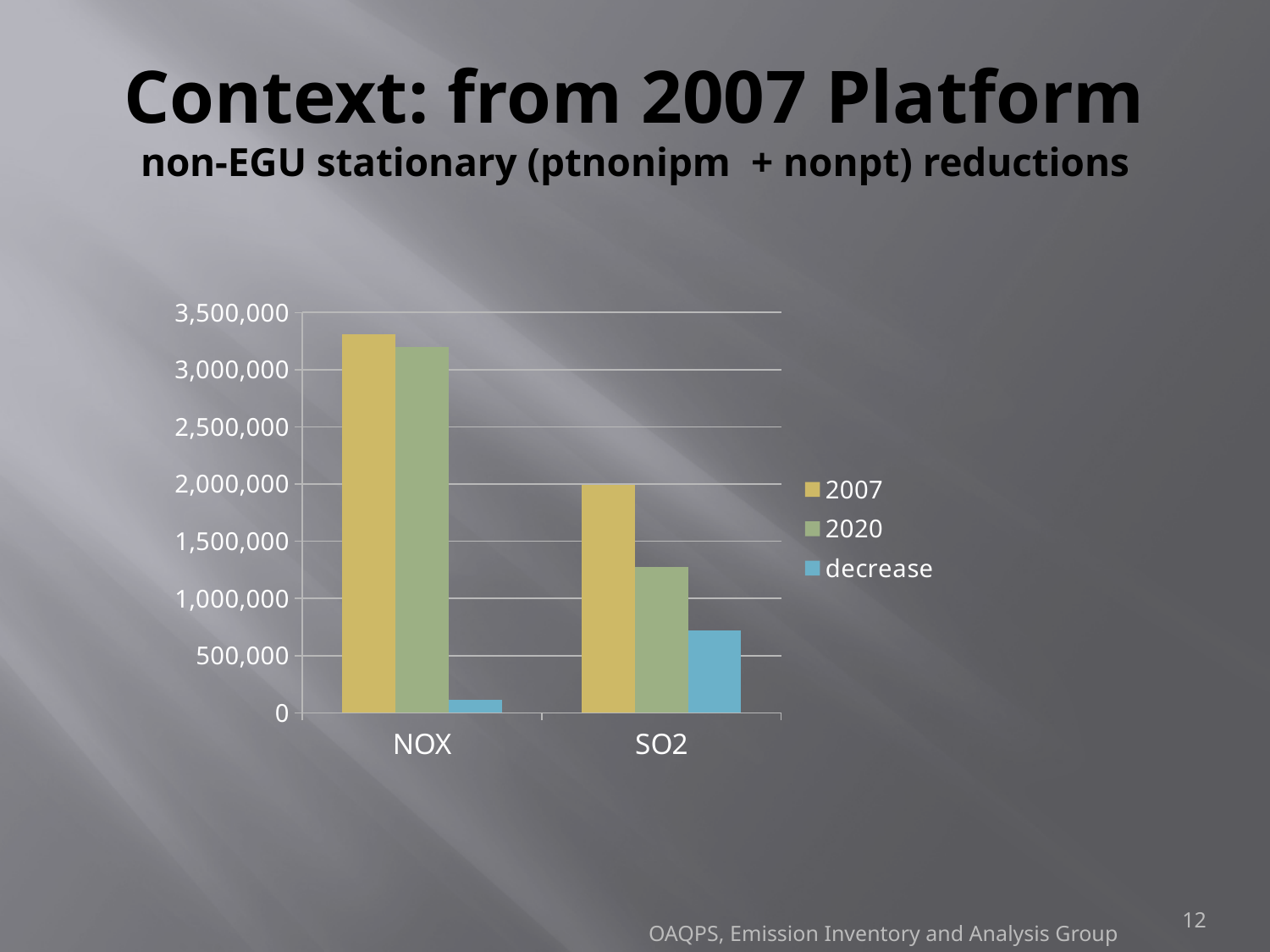
What is the subtitle of the slide above the chart? non-EGU stationary (ptnonipm + nonpt) reductions Is the decrease value for SO2 greater or less than 500,000? greater Is the 2007 value for NOX greater or less than 3,000,000? greater Which category has the larger decrease value, NOX or SO2? SO2 Is the 2020 value for SO2 greater or less than 1,500,000? less How many series does the legend list? 3 How many categories are shown on the x axis? 2 Which series is shown in blue in the legend? decrease Which category has the higher 2007 value, NOX or SO2? NOX What kind of chart is shown on the slide? bar chart